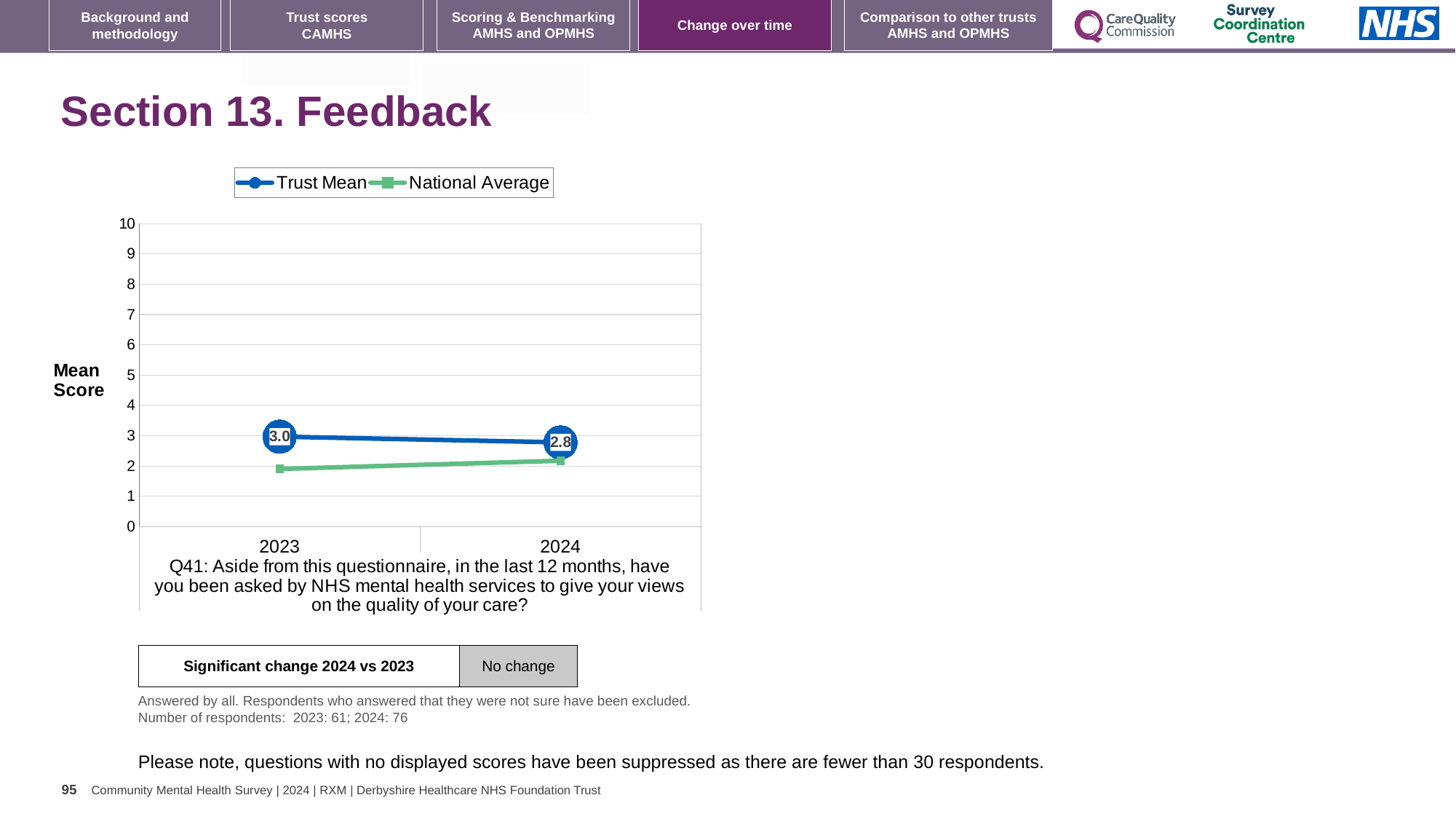
Does the Trust Mean rise or fall from 2023 to 2024? fall What is the Trust Mean score for 2024? 2.8 Does the National Average rise or fall from 2023 to 2024? rise In which year is the Trust Mean score higher? 2023 In which year is the Trust Mean score lower? 2024 In 2023, which is higher: the Trust Mean or the National Average? Trust Mean How many series does the chart legend list? 2 What is the Trust Mean score for 2023? 3.0 What kind of chart is shown on the slide? line chart How many years are shown on the x axis of the chart? 2 Is the National Average value for 2023 greater or less than 3? less What is the difference between the Trust Mean scores for 2023 and 2024? 0.2